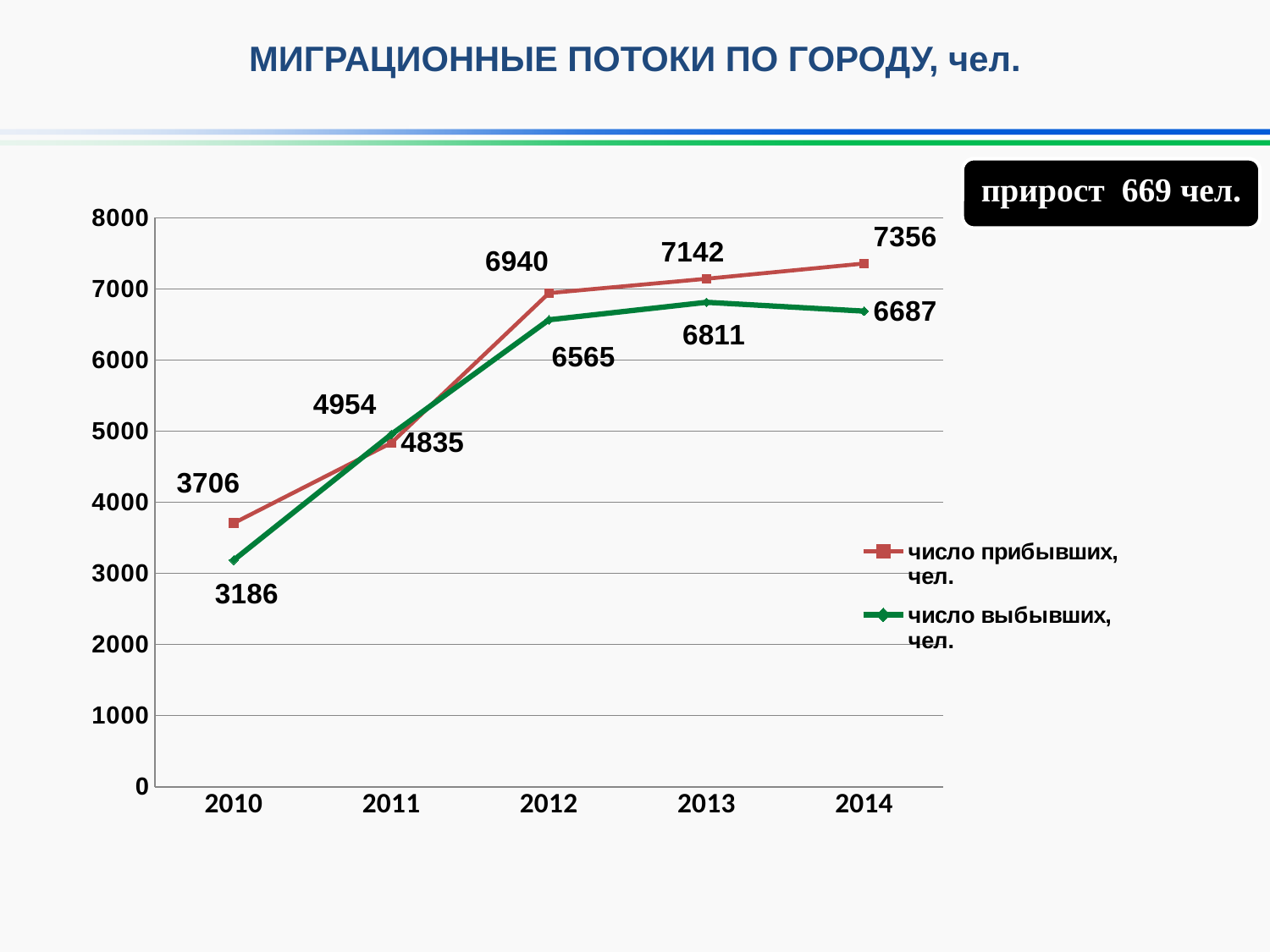
How many series does the legend list? 2 What is the difference between число прибывших, чел. and число выбывших, чел. in 2014? 669 What is the value of число прибывших, чел. in 2014? 7356 How many years are plotted on the x axis? 5 In which year is число прибывших, чел. highest? 2014 What is the value of число прибывших, чел. in 2010? 3706 Which series has the larger value in 2011, число прибывших, чел. or число выбывших, чел.? число выбывших, чел. What is the title of the chart? МИГРАЦИОННЫЕ ПОТОКИ ПО ГОРОДУ, чел. What type of chart is shown on the slide? line chart What is the value of число выбывших, чел. in 2012? 6565 Does число прибывших, чел. rise or fall from 2010 to 2014? rise In which year is число выбывших, чел. lowest? 2010